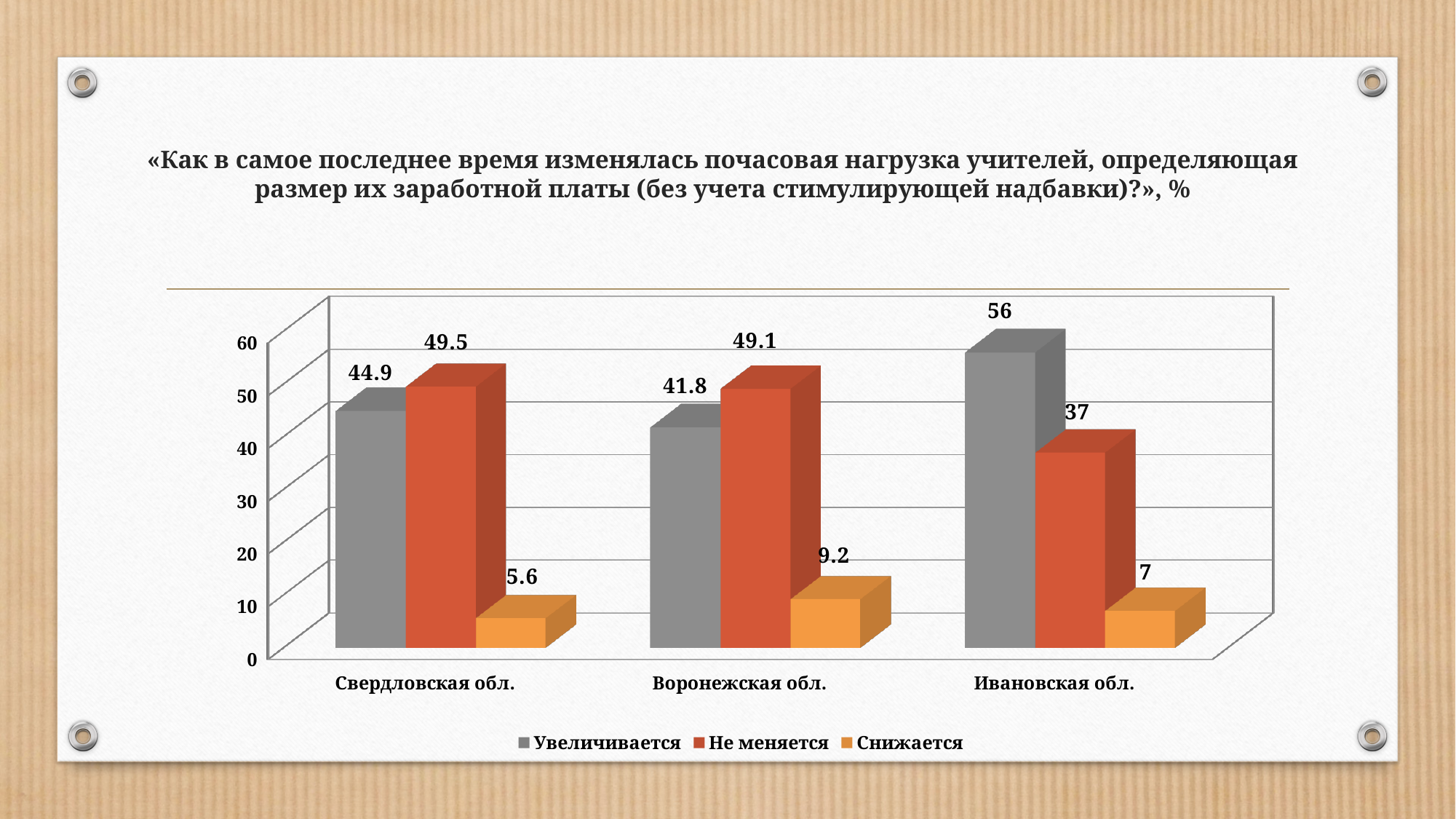
What is the value for «Не меняется» in Воронежская обл.? 49.1 Which region has the highest value for «Увеличивается»? Ивановская обл. Is the value for «Снижается» in Воронежская обл. greater or less than 10? less What is the value for «Увеличивается» in Свердловская обл.? 44.9 How many regions are shown on the x axis? 3 What is the value for «Снижается» in Свердловская обл.? 5.6 What kind of chart is shown on the slide? bar chart Which is larger in Воронежская обл.: «Увеличивается» or «Не меняется»? Не меняется How many series does the legend list? 3 What is the difference between «Увеличивается» and «Не меняется» in Ивановская обл.? 19 What is the value for «Снижается» in Ивановская обл.? 7 Which region has the lowest value for «Не меняется»? Ивановская обл.